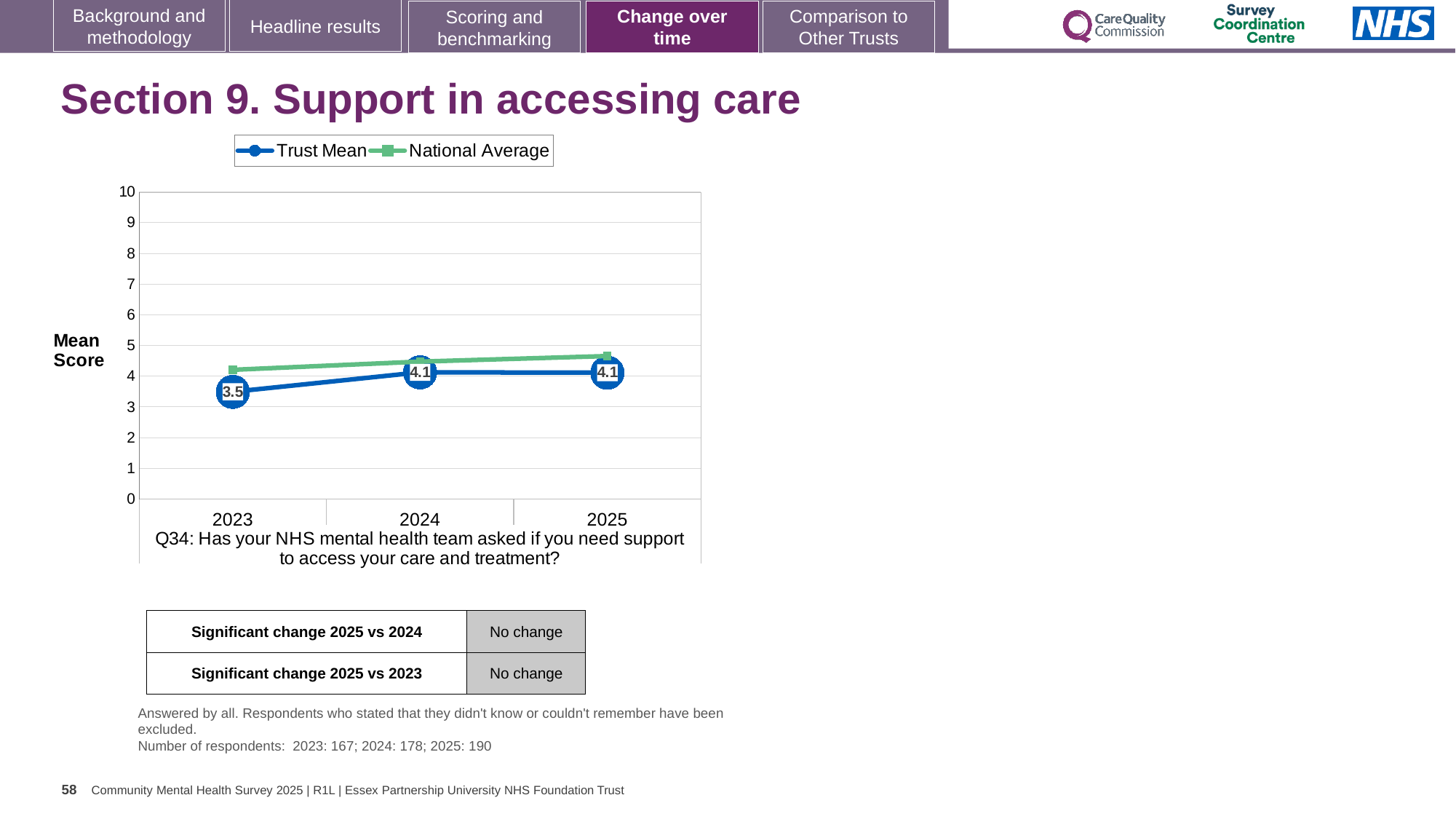
What is the label on the y axis of the chart? Mean Score Does the Trust Mean score rise or fall from 2023 to 2025? rise How many series does the chart legend list? 2 What is the Trust Mean score for 2025? 4.1 Is the National Average value for 2025 greater or less than 4? greater In which year is the Trust Mean score lowest? 2023 What kind of chart is shown on the slide? line chart How many years are shown on the x axis of the chart? 3 Which is larger, the Trust Mean score in 2023 or in 2024? 2024 What is the Trust Mean score for 2023? 3.5 What is the difference between the Trust Mean score in 2024 and in 2023? 0.6 In 2023, which series has the higher value, Trust Mean or National Average? National Average